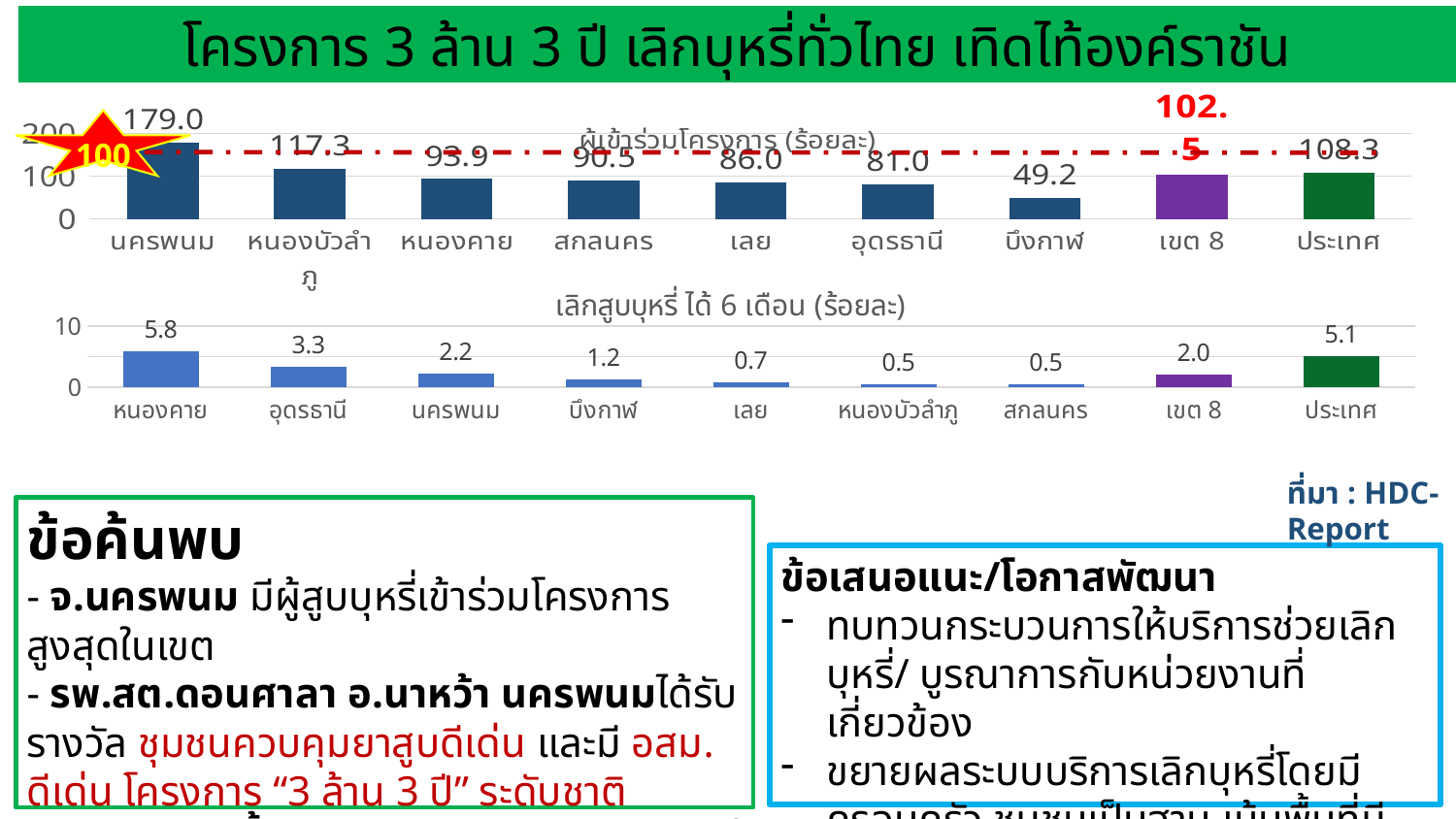
In the bottom chart (เลิกสูบบุหรี่ ได้ 6 เดือน (ร้อยละ)), what is the value for หนองคาย? 5.8 In the top chart (ผู้เข้าร่วมโครงการ (ร้อยละ)), which category has the lowest value? บึงกาฬ In the top chart (ผู้เข้าร่วมโครงการ (ร้อยละ)), what is the value for นครพนม? 179.0 What type of chart is the bottom chart (เลิกสูบบุหรี่ ได้ 6 เดือน (ร้อยละ))? Bar chart In the top chart (ผู้เข้าร่วมโครงการ (ร้อยละ)), what is the value for เขต 8? 102.5 In the bottom chart (เลิกสูบบุหรี่ ได้ 6 เดือน (ร้อยละ)), what is the difference between อุดรธานี and นครพนม? 1.1 In the bottom chart (เลิกสูบบุหรี่ ได้ 6 เดือน (ร้อยละ)), which category has the highest value? หนองคาย In the top chart (ผู้เข้าร่วมโครงการ (ร้อยละ)), what is the difference between นครพนม and หนองบัวลำภู? 61.7 In the top chart (ผู้เข้าร่วมโครงการ (ร้อยละ)), which is larger, เลย or อุดรธานี? เลย In the top chart (ผู้เข้าร่วมโครงการ (ร้อยละ)), how many bars are plotted? 9 In the bottom chart (เลิกสูบบุหรี่ ได้ 6 เดือน (ร้อยละ)), what is the value for ประเทศ? 5.1 In the bottom chart (เลิกสูบบุหรี่ ได้ 6 เดือน (ร้อยละ)), is the value for เขต 8 greater or less than ประเทศ? less